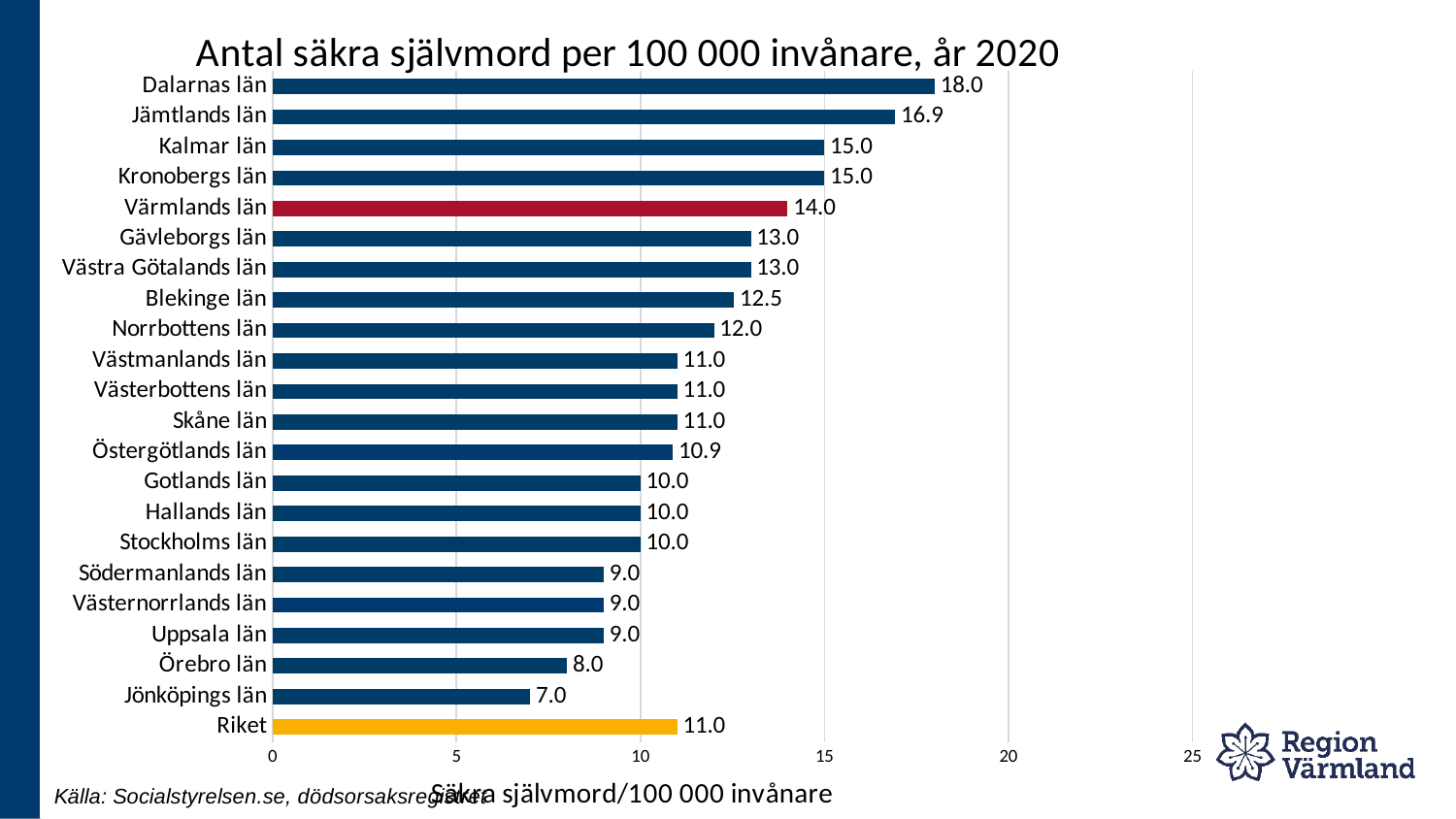
What is the title of the chart? Antal säkra självmord per 100 000 invånare, år 2020 Is the value for Örebro län greater or less than 10? less What is the value for Värmlands län? 14.0 What is the value for Riket? 11.0 Which is larger, the value for Blekinge län or the value for Norrbottens län? Blekinge län What is the difference between the values for Dalarnas län and Jönköpings län? 11.0 What is the difference between the values for Värmlands län and Riket? 3.0 How many bars are shown in the chart? 22 Which category has the highest value? Dalarnas län Which category has the lowest value? Jönköpings län What kind of chart is shown on the slide? bar chart What is the value for Jämtlands län? 16.9